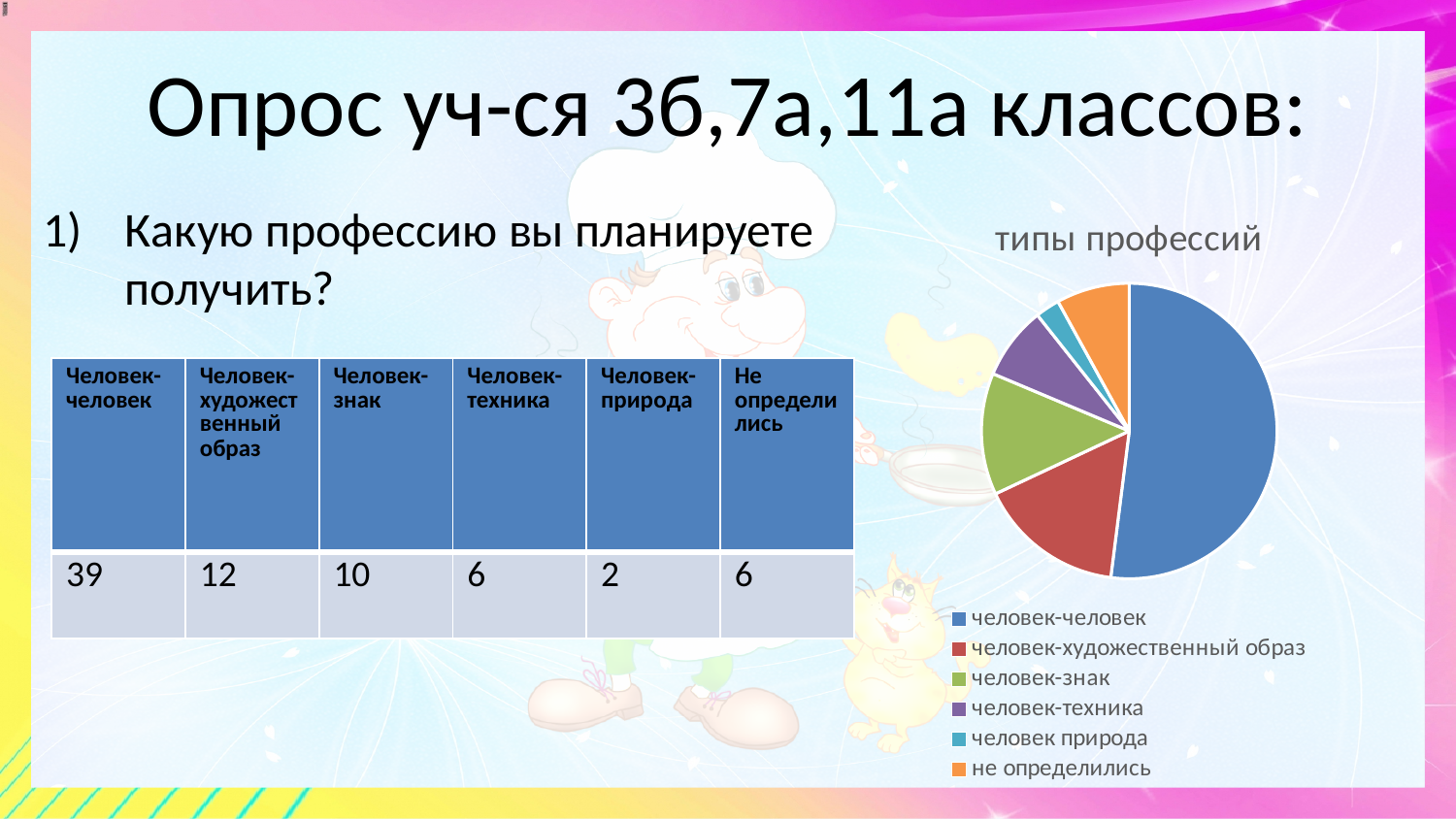
Which category has the largest slice in the pie chart? человек-человек What is the title of the pie chart? типы профессий In the pie chart, which slice is larger: человек-человек or человек-знак? человек-человек What colour is the человек-знак slice in the pie chart? green Which category has the smallest slice in the pie chart? человек природа According to the table on the slide, how many respondents chose Человек-человек? 39 In the pie chart, which slice is larger: не определились or человек природа? не определились How many entries does the legend of the pie chart list? 6 What kind of chart is shown on the slide? pie chart In the pie chart, which slice is larger: человек-техника or человек природа? человек-техника According to the table on the slide, how many respondents chose Человек-природа? 2 How many slices does the pie chart have? 6